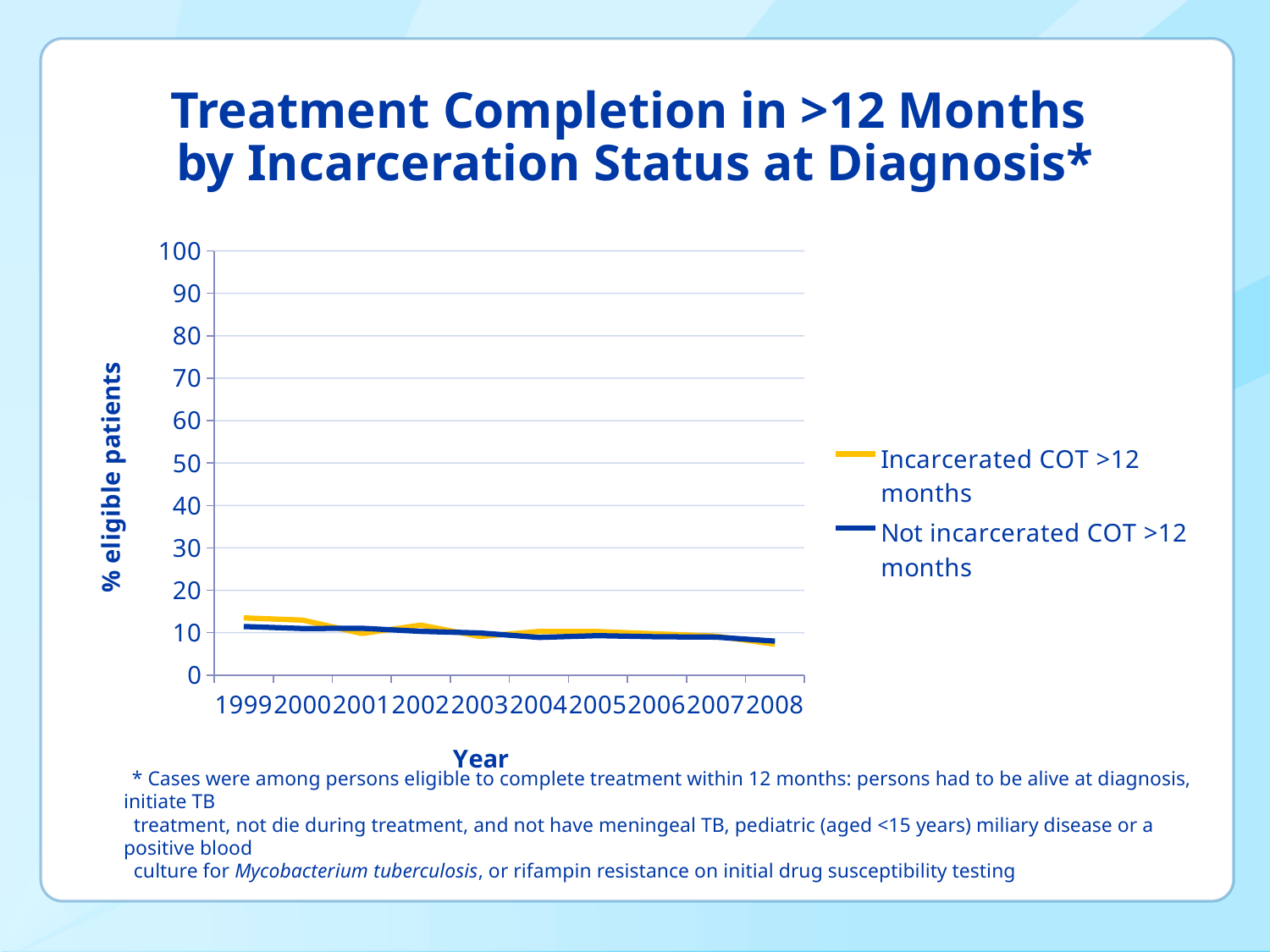
Is the value for Incarcerated COT >12 months in 1999 greater or less than 20? less Is the value for Not incarcerated COT >12 months in 2005 greater or less than 50? less What is the label of the y axis? % eligible patients How many years are plotted along the x axis? 10 In which year is the value for Incarcerated COT >12 months lowest? 2008 How many series does the legend list? 2 Do the values for Not incarcerated COT >12 months generally rise or fall from 1999 to 2008? fall Is the value for Incarcerated COT >12 months in 2008 greater or less than 10? less What is the first year shown on the x axis? 1999 What kind of chart is shown on the slide? line chart In 1999, which series has the higher value: Incarcerated COT >12 months or Not incarcerated COT >12 months? Incarcerated COT >12 months